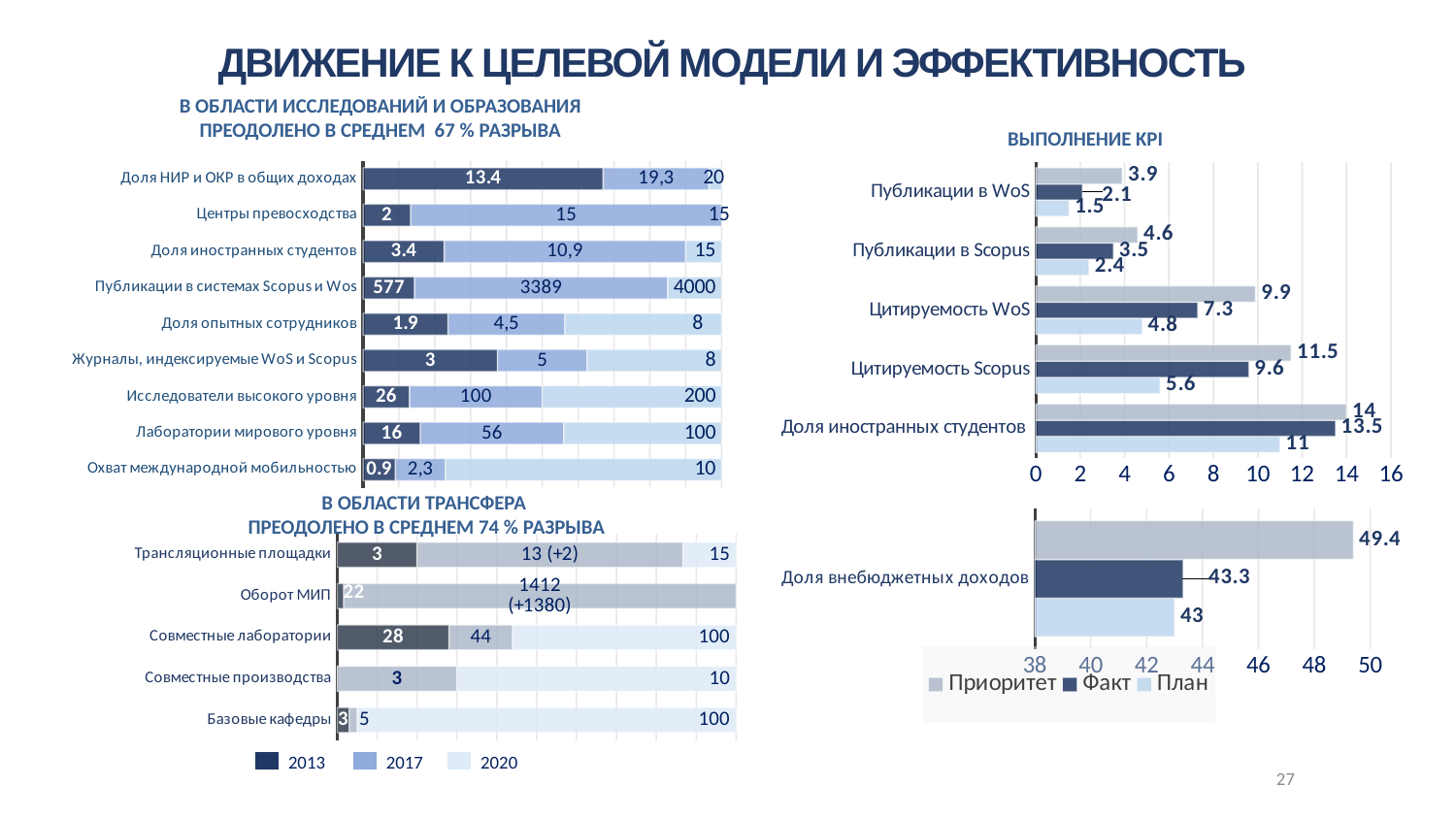
In the Доля внебюджетных доходов chart, what is the Приоритет value? 49.4 How many categories are shown in the top-left chart (В ОБЛАСТИ ИССЛЕДОВАНИЙ И ОБРАЗОВАНИЯ)? 9 In the ВЫПОЛНЕНИЕ KPI chart, which category has the highest Приоритет value? Доля иностранных студентов In the top-left chart (В ОБЛАСТИ ИССЛЕДОВАНИЙ И ОБРАЗОВАНИЯ), what is the 2020 value for Исследователи высокого уровня? 200 What kind of chart is the ВЫПОЛНЕНИЕ KPI chart? Bar chart In the top-left chart (В ОБЛАСТИ ИССЛЕДОВАНИЙ И ОБРАЗОВАНИЯ), what is the 2013 value for Публикации в системах Scopus и Wos? 577 In the ВЫПОЛНЕНИЕ KPI chart, what is the difference between the Приоритет and Факт values for Публикации в Scopus? 1.1 In the ВЫПОЛНЕНИЕ KPI chart, what is the Приоритет value for Цитируемость Scopus? 11.5 In the ВЫПОЛНЕНИЕ KPI chart, which category has the lowest План value? Публикации в WoS In the Доля внебюджетных доходов chart, what is the difference between the Приоритет and План values? 6.4 How many series does the legend of the right-hand charts list? 3 In the ВЫПОЛНЕНИЕ KPI chart, what is the Факт value for Цитируемость WoS? 7.3